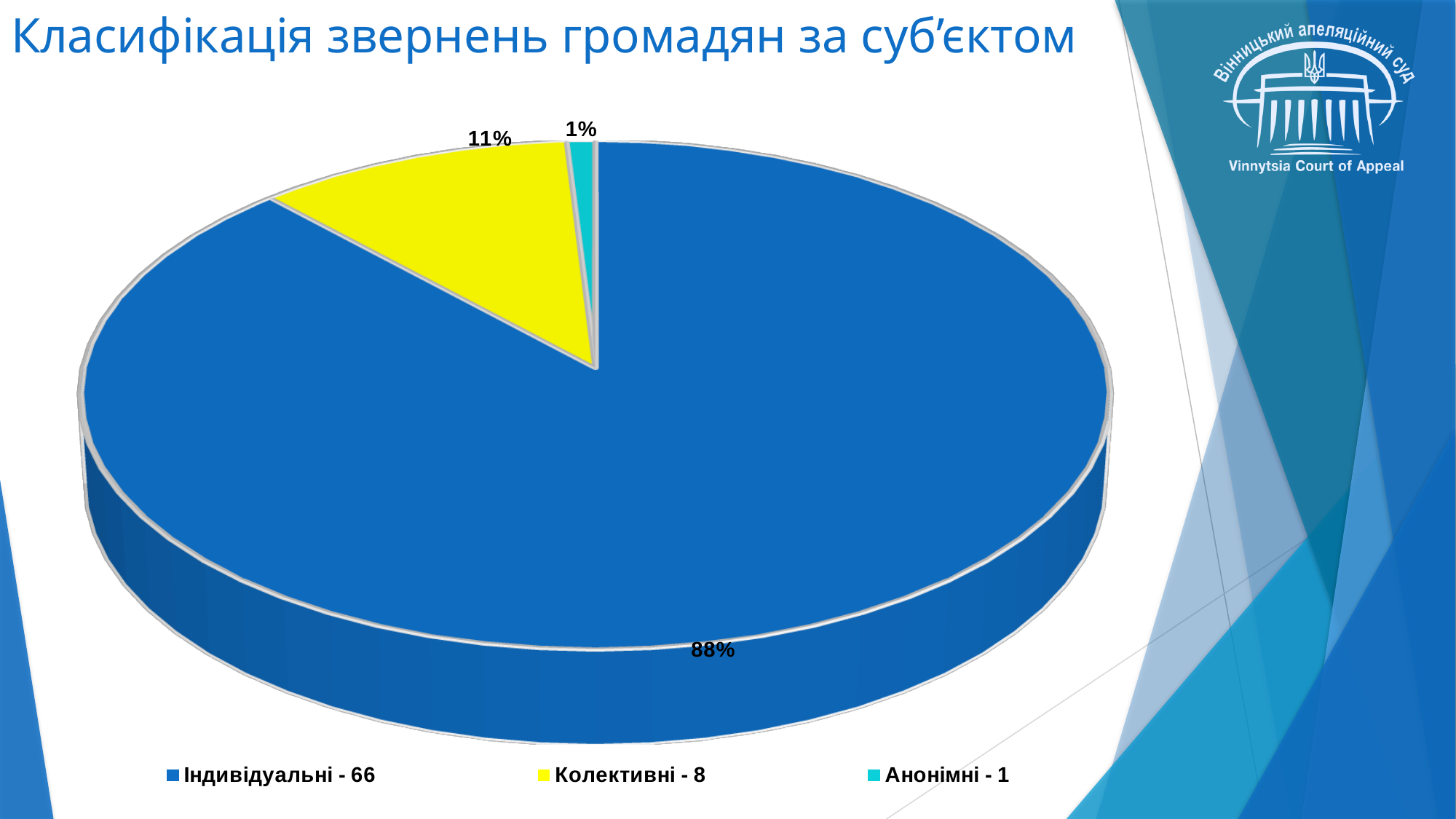
Which category has the largest slice of the pie? Індивідуальні What percentage share does the Індивідуальні slice have? 88% What percentage share does the Анонімні slice have? 1% What percentage share does the Колективні slice have? 11% What count is given for Колективні in the legend? 8 What colour is the Колективні slice? yellow What kind of chart is shown on the slide? pie chart What count is given for Індивідуальні in the legend? 66 Which category has the smallest slice of the pie? Анонімні What is the difference in percentage points between the Індивідуальні and Колективні slices? 77% How many categories does the pie chart show? 3 Which slice is larger, Колективні or Анонімні? Колективні